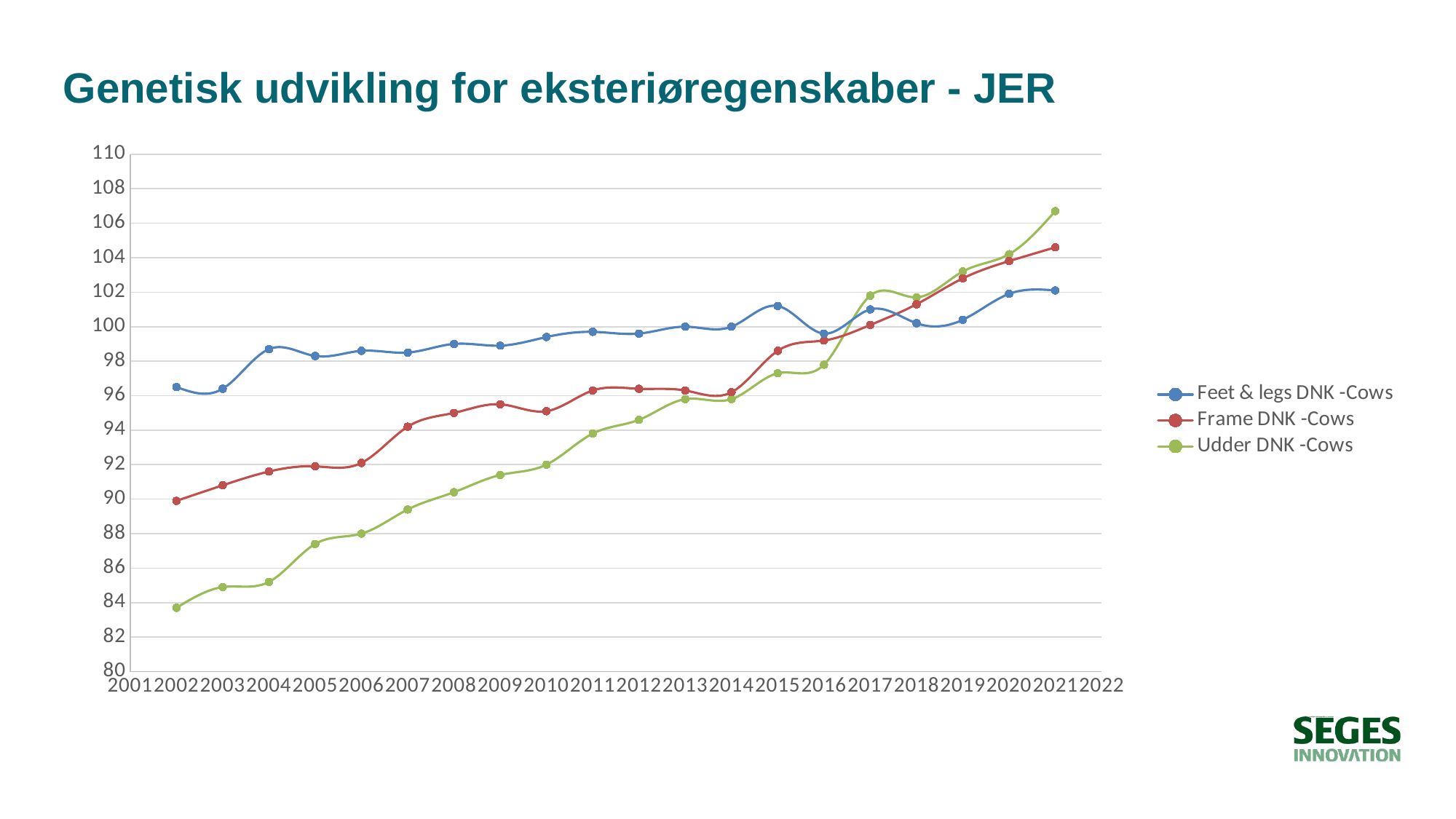
Is the value for Udder DNK -Cows in 2002 greater or less than 86? less Is the value for Frame DNK -Cows in 2002 greater or less than 92? less In 2002, which is larger: Feet & legs DNK -Cows or Frame DNK -Cows? Feet & legs DNK -Cows How many yearly data points are plotted for the Udder DNK -Cows series? 20 How many series does the legend list? 3 Which series has the highest value in 2021? Udder DNK -Cows What is the title of the chart? Genetisk udvikling for eksteriøregenskaber - JER Is the value for Feet & legs DNK -Cows in 2021 greater or less than 100? greater What kind of chart is shown on the slide? line chart Does the Udder DNK -Cows series rise or fall from 2002 to 2021? rise Which series has the lowest value in 2021? Feet & legs DNK -Cows Which series has the lowest value in 2002? Udder DNK -Cows